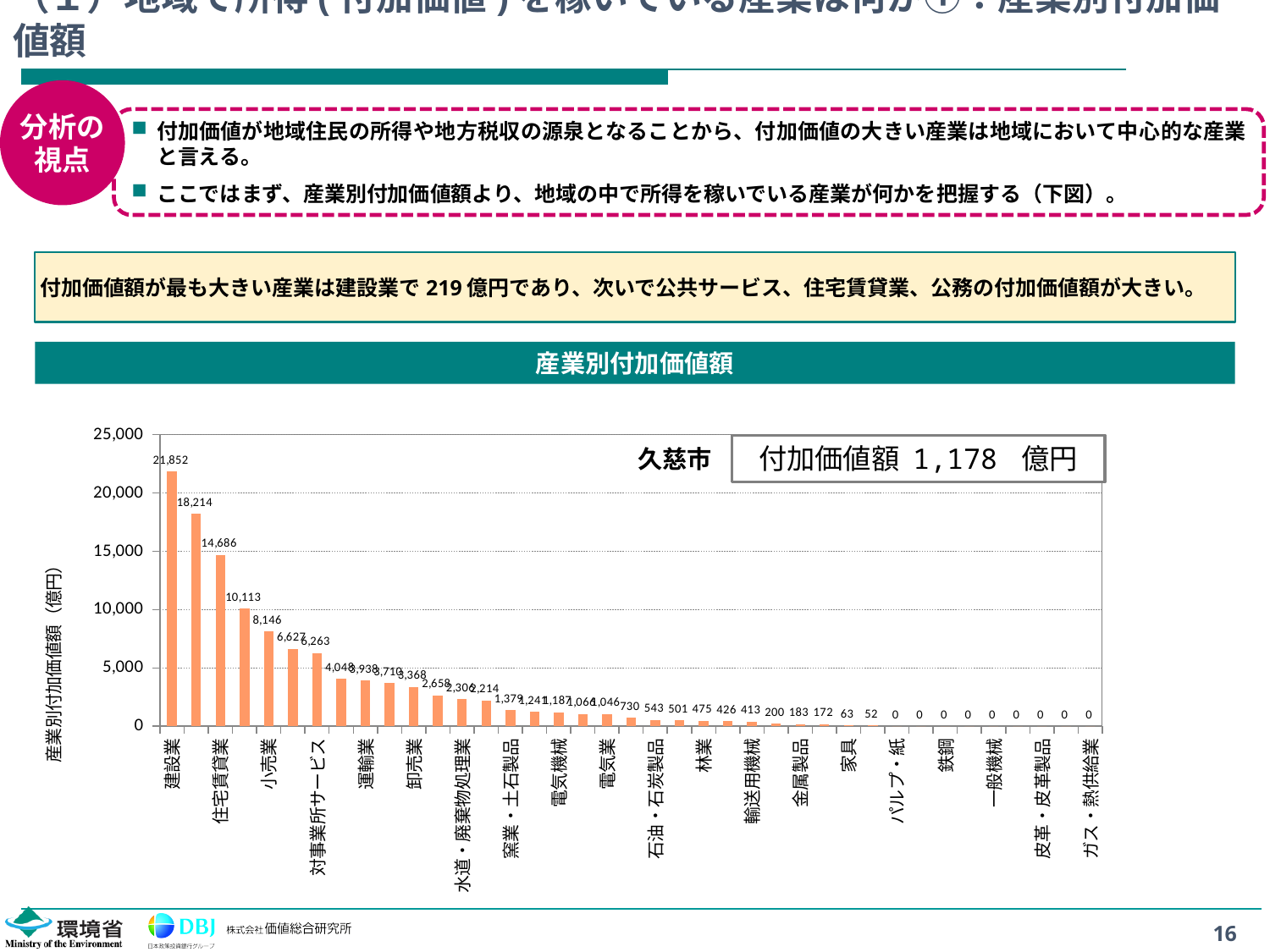
Is the value for 対事業所サービス in the 産業別付加価値額 chart greater or less than 5,000? greater What type of chart is shown under the title 産業別付加価値額? bar chart Which has the larger value in the 産業別付加価値額 chart, 小売業 or 運輸業? 小売業 What total 付加価値額 is shown for 久慈市 in the box on the chart? 1,178 億円 What is the value for 住宅賃貸業 in the 産業別付加価値額 chart? 14,686 What is the y-axis title of the 産業別付加価値額 chart? 産業別付加価値額（億円） What is the value for 建設業 in the 産業別付加価値額 chart? 21,852 What is the difference between the values for 建設業 and 住宅賃貸業 in the 産業別付加価値額 chart? 7,166 Is the value for 住宅賃貸業 in the 産業別付加価値額 chart greater or less than 10,000? greater Do the bar values rise or fall from left to right in the 産業別付加価値額 chart? fall What is the value for 小売業 in the 産業別付加価値額 chart? 8,146 Which industry has the highest value in the 産業別付加価値額 chart? 建設業